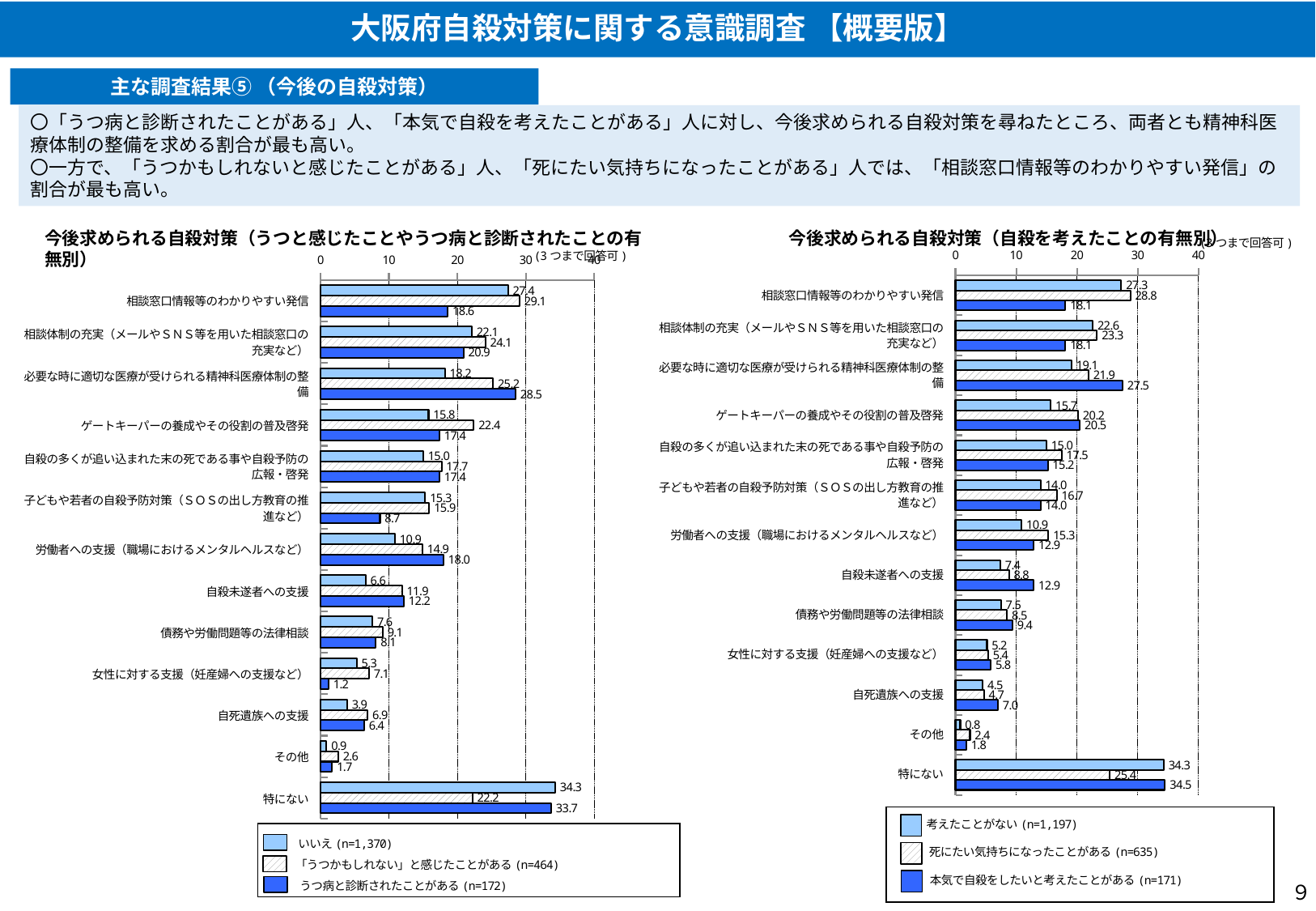
In the left chart (うつと感じたことやうつ病と診断されたことの有無別), which category has the lowest value for いいえ? その他 In the left chart (うつと感じたことやうつ病と診断されたことの有無別), what is the value for 「うつかもしれない」と感じたことがある for 相談窓口情報等のわかりやすい発信? 29.1 In the right chart (自殺を考えたことの有無別), which is larger for 労働者への支援（職場におけるメンタルヘルスなど）: the 考えたことがない value or the 死にたい気持ちになったことがある value? 死にたい気持ちになったことがある In the right chart (自殺を考えたことの有無別), what is the value for 本気で自殺をしたいと考えたことがある for 特にない? 34.5 What type of chart is the right chart (自殺を考えたことの有無別)? Bar chart In the right chart (自殺を考えたことの有無別), what is the value for 死にたい気持ちになったことがある for 相談窓口情報等のわかりやすい発信? 28.8 In the right chart (自殺を考えたことの有無別), which category has the highest value for 本気で自殺をしたいと考えたことがある? 特にない In the left chart (うつと感じたことやうつ病と診断されたことの有無別), what is the value for うつ病と診断されたことがある for 必要な時に適切な医療が受けられる精神科医療体制の整備? 28.5 How many series does the legend of the left chart (うつと感じたことやうつ病と診断されたことの有無別) list? 3 In the left chart (うつと感じたことやうつ病と診断されたことの有無別), is the value for 特にない for いいえ greater or less than 30? greater In the left chart (うつと感じたことやうつ病と診断されたことの有無別), what is the difference between the うつ病と診断されたことがある value and the いいえ value for 必要な時に適切な医療が受けられる精神科医療体制の整備? 10.3 How many categories are shown in the right chart (自殺を考えたことの有無別)? 13